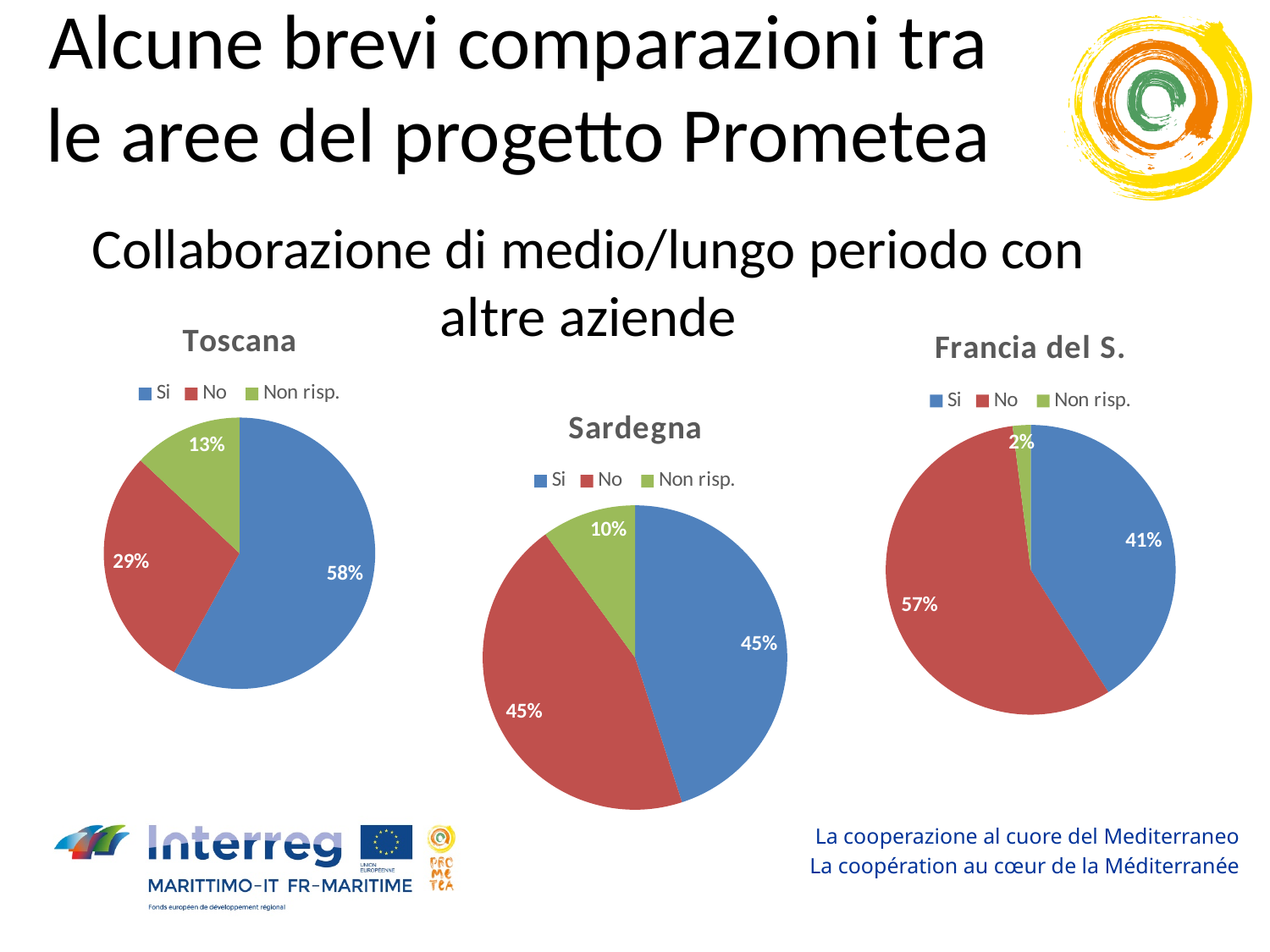
How many categories does the Sardegna chart show? 3 In the Toscana chart, what share of responses is "Si"? 58% In the Francia del S. chart, which category has the smallest slice? Non risp. In the Toscana chart, which category has the largest slice? Si In the Sardegna chart, what share of responses is "Non risp."? 10% In the Francia del S. chart, which is larger, "Si" or "No"? No In the Francia del S. chart, what share of responses is "Si"? 41% What are the legend entries of the Toscana chart? Si, No, Non risp. In the Francia del S. chart, what share of responses is "No"? 57% In the Toscana chart, what share of responses is "No"? 29% In the Toscana chart, what is the difference between the "Si" and "No" shares? 29% What kind of chart is the Sardegna chart? Pie chart